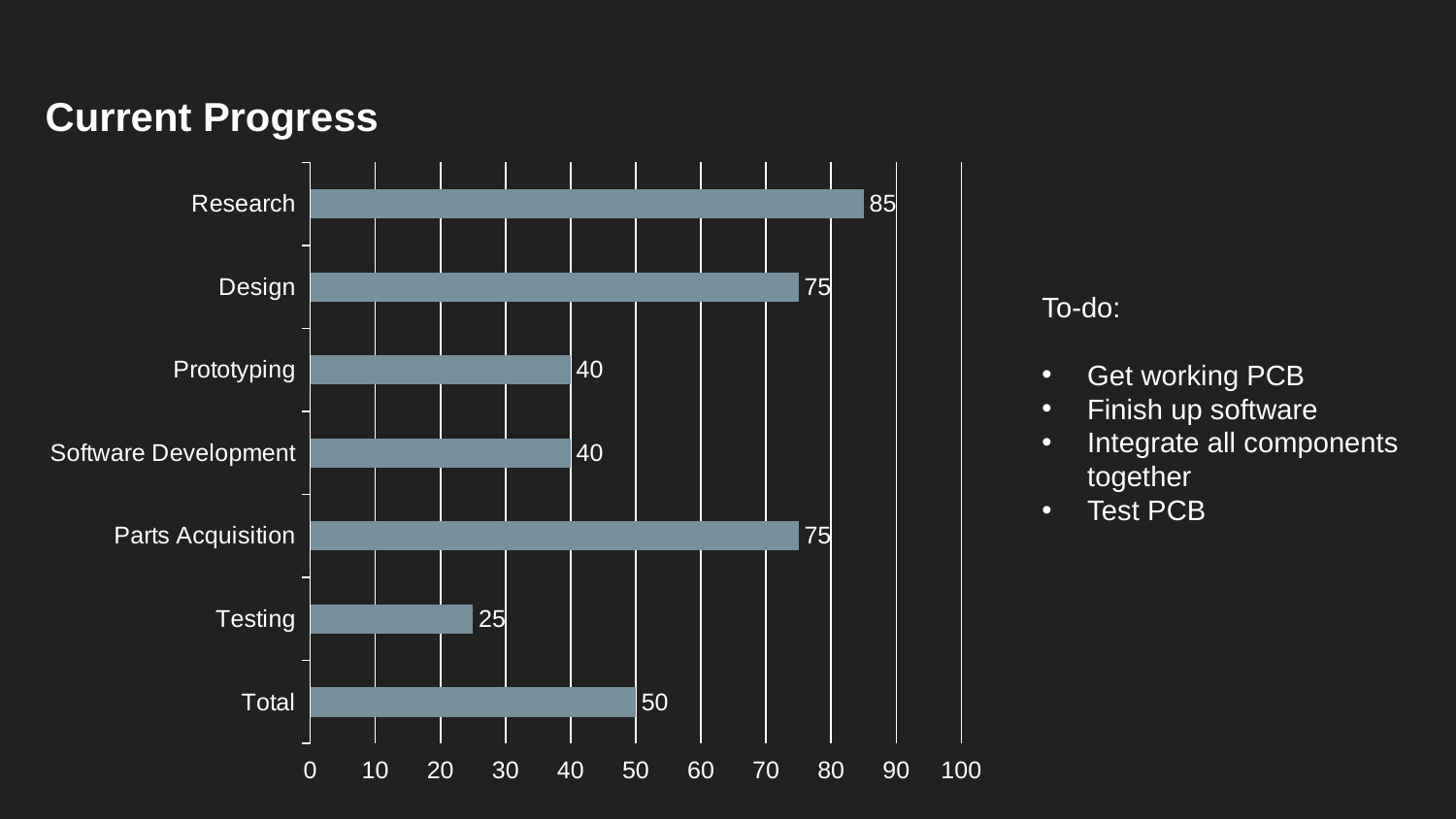
What is the value for Research? 85 What kind of chart is shown on the slide? Bar chart What is the difference between the values for Research and Design? 10 What is the difference between the values for Total and Testing? 25 What is the value for Testing? 25 What is the value for Total? 50 How many categories are shown in the chart? 7 Which category has the highest value? Research Which is larger, the value for Parts Acquisition or the value for Prototyping? Parts Acquisition Is the value for Design greater or less than 70? greater Which category has the lowest value? Testing What is the value for Software Development? 40